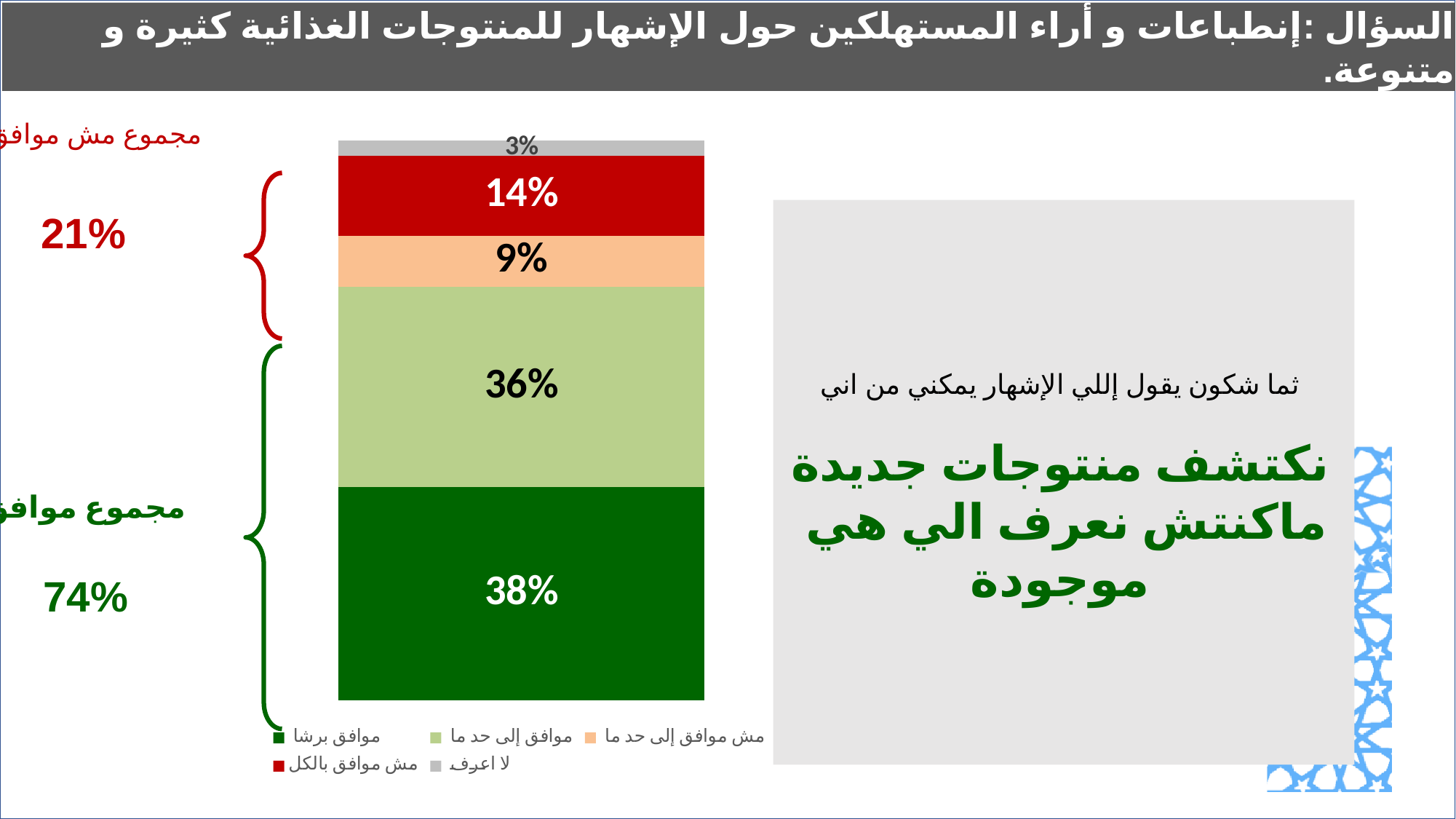
What is the value for the segment labelled موافق إلى حد ما (light green)? 36% What is the value for the segment labelled موافق برشا (dark green)? 38% Which segment of the stacked bar has the lowest value? لا اعرف What kind of chart is shown on the slide? stacked bar chart What total is shown for مجموع موافق (the agree group) next to the green bracket? 74% Which segment of the stacked bar has the highest value? موافق برشا How many series does the legend list? 5 What is the value for the segment labelled مش موافق بالكل (red)? 14% What is the value for the segment labelled لا اعرف (grey)? 3% Which is larger, the موافق برشا segment or the موافق إلى حد ما segment? موافق برشا What is the value for the segment labelled مش موافق إلى حد ما (orange)? 9% What is the difference between the مش موافق بالكل segment and the مش موافق إلى حد ما segment? 5%